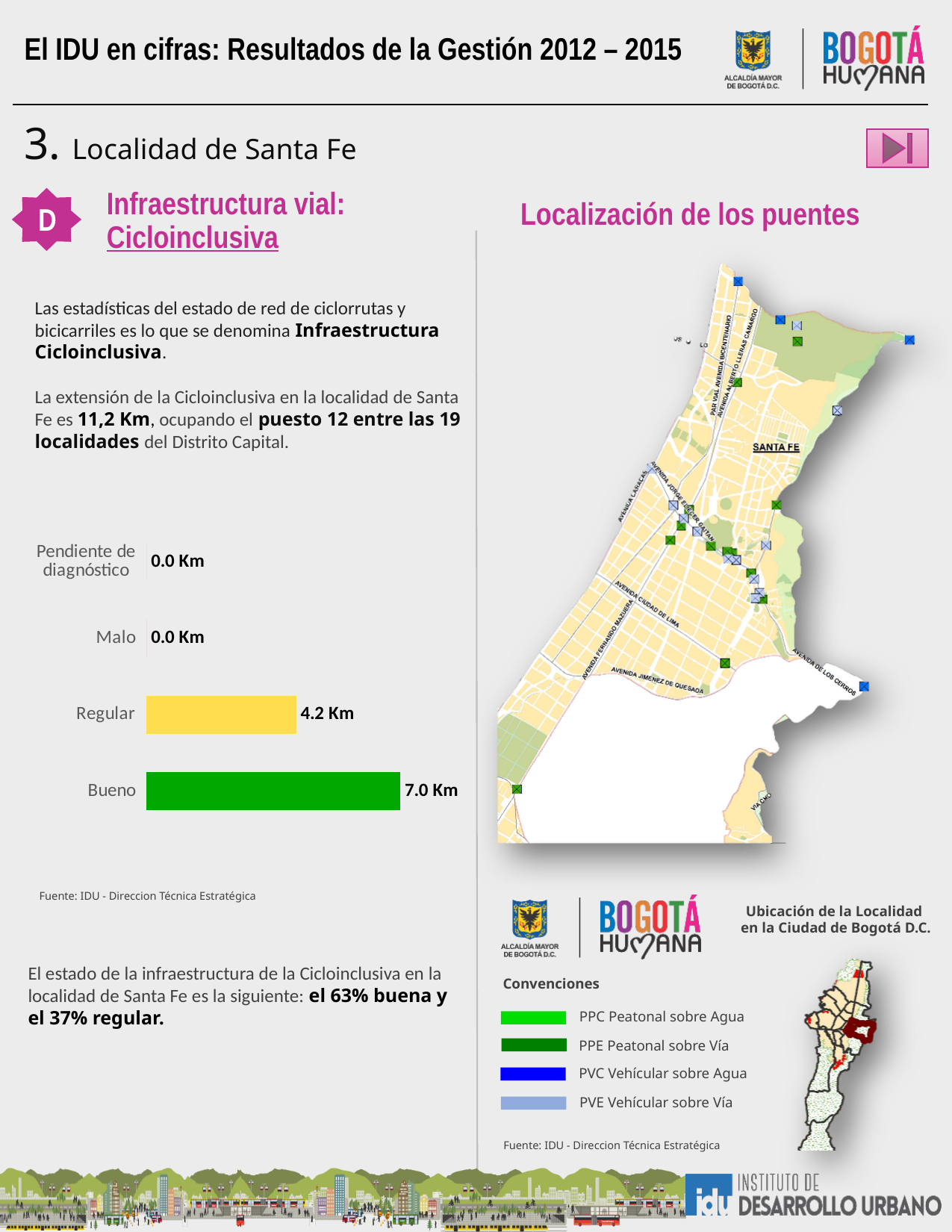
What is the difference between the Bueno and Regular values in the bar chart? 2.8 Km Which is larger in the bar chart, Bueno or Regular? Bueno What kind of chart is used to show the state of the cycling infrastructure? Bar chart What colour is the Regular bar in the bar chart? Yellow Which category has the highest value in the bar chart? Bueno How many categories does the bar chart show? 4 What colour is the Bueno bar in the bar chart? Green What is the value for Regular in the bar chart? 4.2 Km What is the value for Pendiente de diagnóstico in the bar chart? 0.0 Km What is the value for Malo in the bar chart? 0.0 Km What is the total of all the values shown in the bar chart? 11.2 Km What is the value for Bueno in the bar chart? 7.0 Km